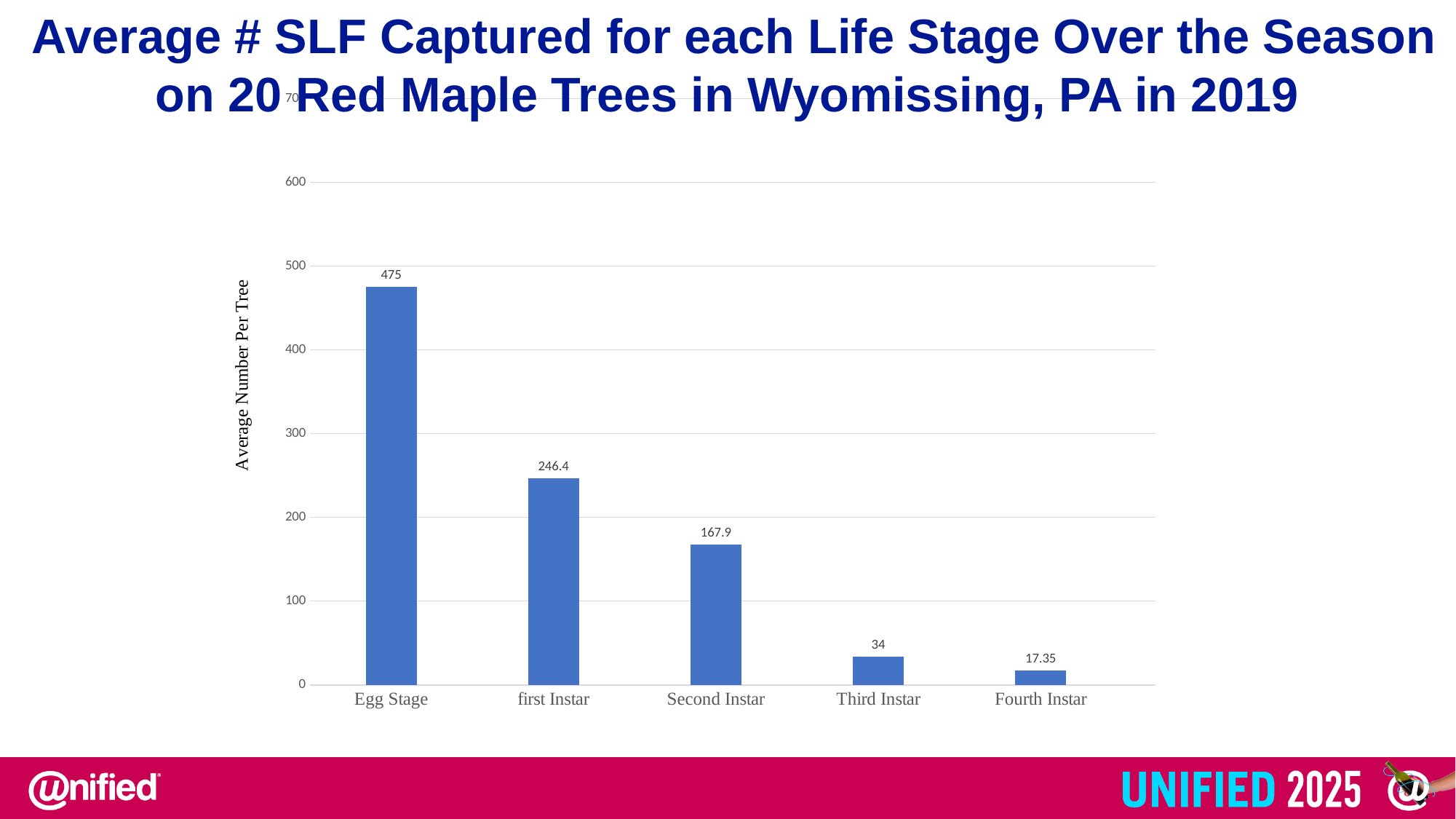
What is the average number per tree for the Fourth Instar? 17.35 What is the average number per tree for the Egg Stage? 475 What is the difference between the Egg Stage value and the first Instar value? 228.6 What kind of chart is shown on the slide? Bar chart What is the average number per tree for the first Instar? 246.4 What is the average number per tree for the Second Instar? 167.9 What is the difference between the Third Instar value and the Fourth Instar value? 16.65 Which life stage has the highest average number per tree? Egg Stage Which is larger, the value for Second Instar or the value for Third Instar? Second Instar Which life stage has the lowest average number per tree? Fourth Instar Do the values rise or fall from Egg Stage to Fourth Instar along the x axis? Fall How many life stages are shown on the x axis? 5